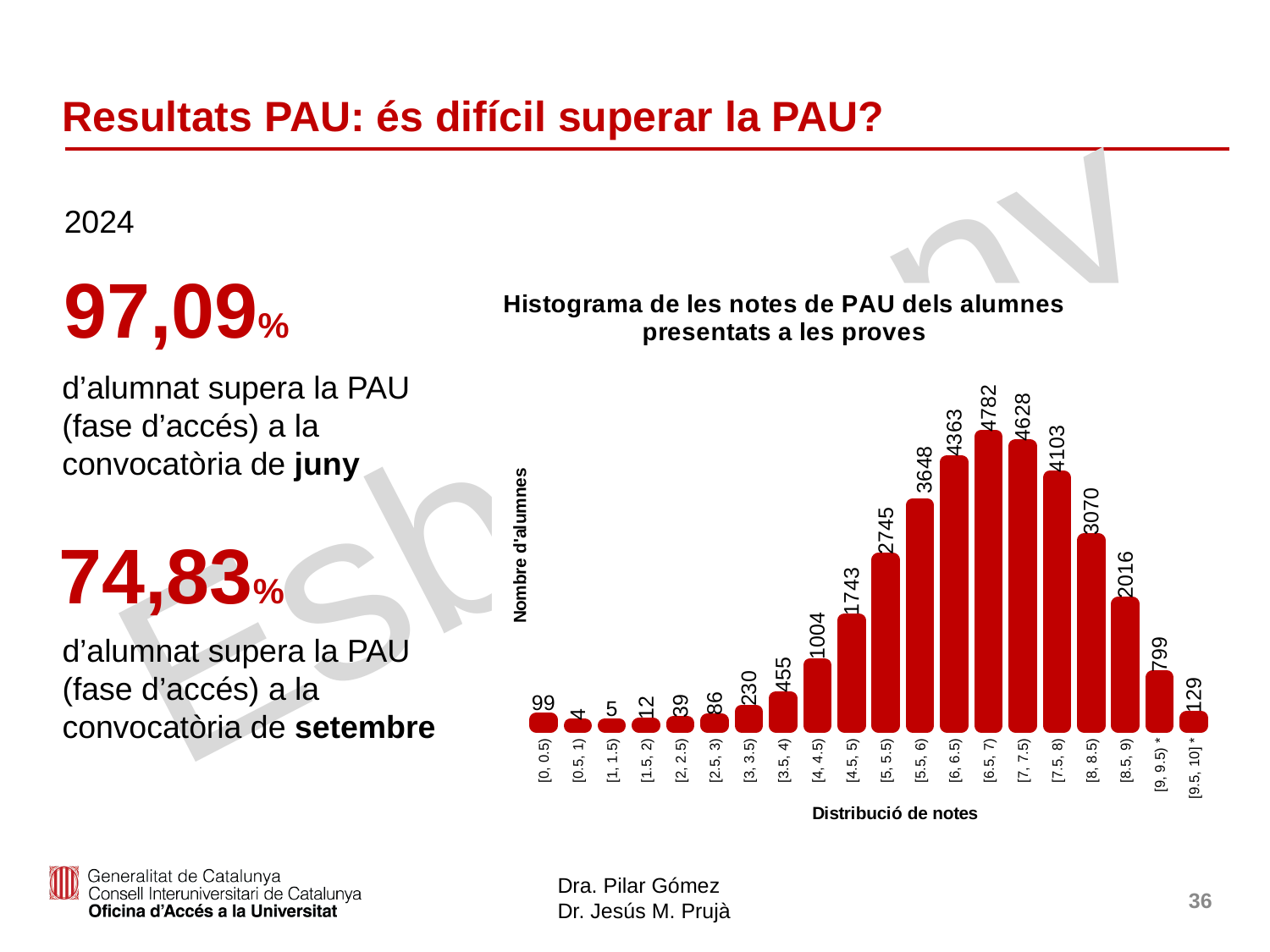
What is the number of students in the [6.5, 7) bin? 4782 What type of chart is used to show the distribution of PAU grades? Bar chart What is the number of students in the [5, 5.5) bin? 2745 What is the difference between the number of students in the [6.5, 7) bin and the [7, 7.5) bin? 154 What is the label of the y axis of the histogram? Nombre d'alumnes Which grade bin has the highest number of students? [6.5, 7) How many grade bins are shown on the x axis of the histogram? 20 Which bin has more students, [5.5, 6) or [8, 8.5)? [5.5, 6) What is the number of students in the [0, 0.5) bin? 99 Do the values rise or fall from the [6.5, 7) bin to the [9.5, 10] bin? Fall What is the number of students in the [9.5, 10] bin? 129 Which grade bin has the lowest number of students? [0.5, 1)